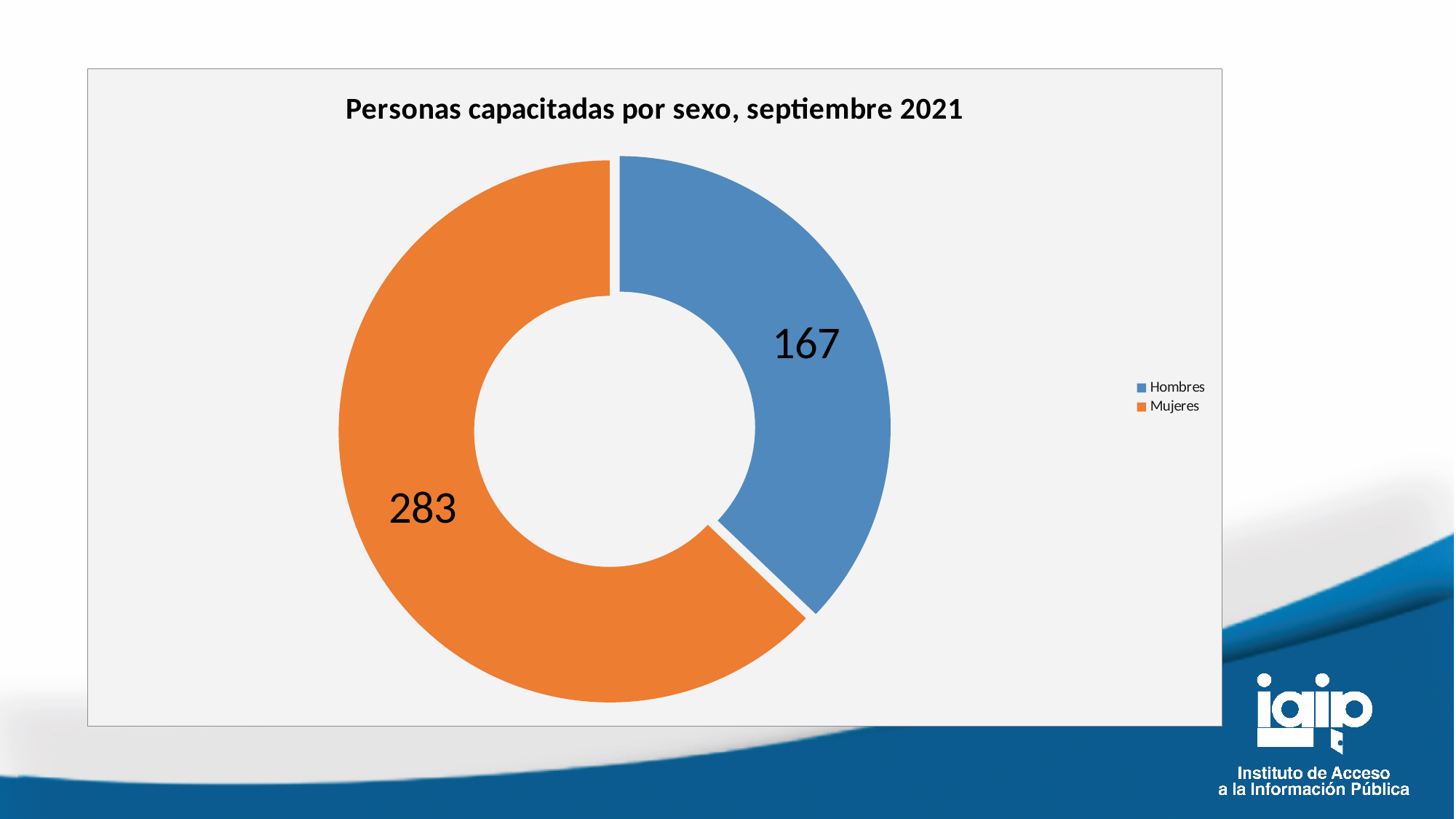
What colour represents Mujeres in the chart? Orange What kind of chart is shown on the slide? Doughnut chart Which is larger, the value for Hombres or the value for Mujeres? Mujeres What is the difference between the values for Mujeres and Hombres? 116 Which category has the highest value? Mujeres What is the total of the two values shown in the chart? 450 Which category has the lowest value? Hombres What is the value for Mujeres? 283 What is the title of the chart? Personas capacitadas por sexo, septiembre 2021 How many categories does the chart show? 2 What is the value for Hombres? 167 How many entries does the legend list? 2